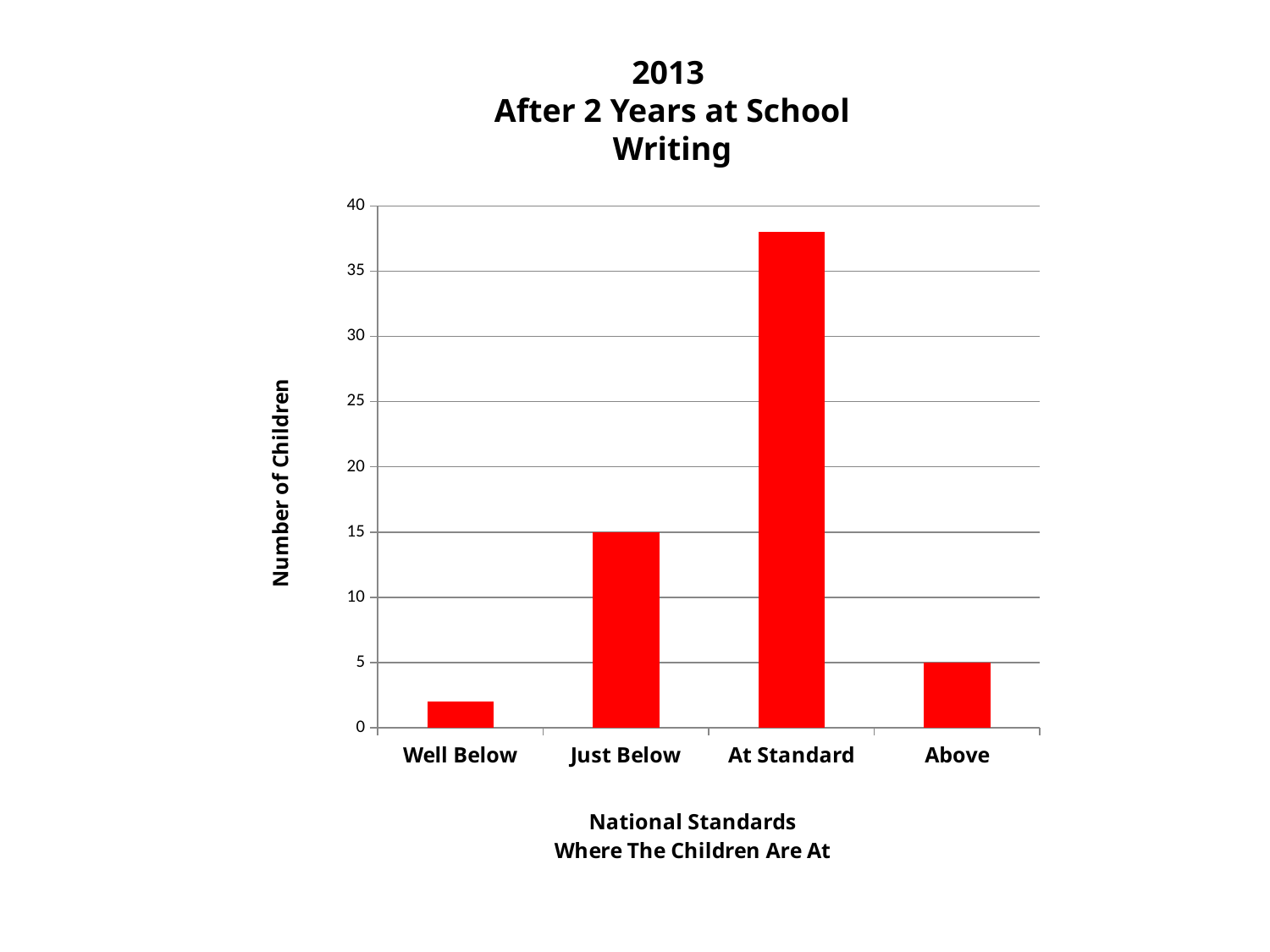
What year is given in the chart title? 2013 Which category has the highest number of children? At Standard Is the value for At Standard greater or less than 35? greater Which category has the lowest number of children? Well Below What is the difference between the number of children for Just Below and for Above? 10 How many categories are shown on the x axis? 4 Is the value for Well Below greater or less than 5? less Which has more children, Just Below or Above? Just Below What is the label on the vertical axis? Number of Children What is the number of children for Just Below? 15 What kind of chart is shown on the slide? bar chart What is the number of children for Above? 5